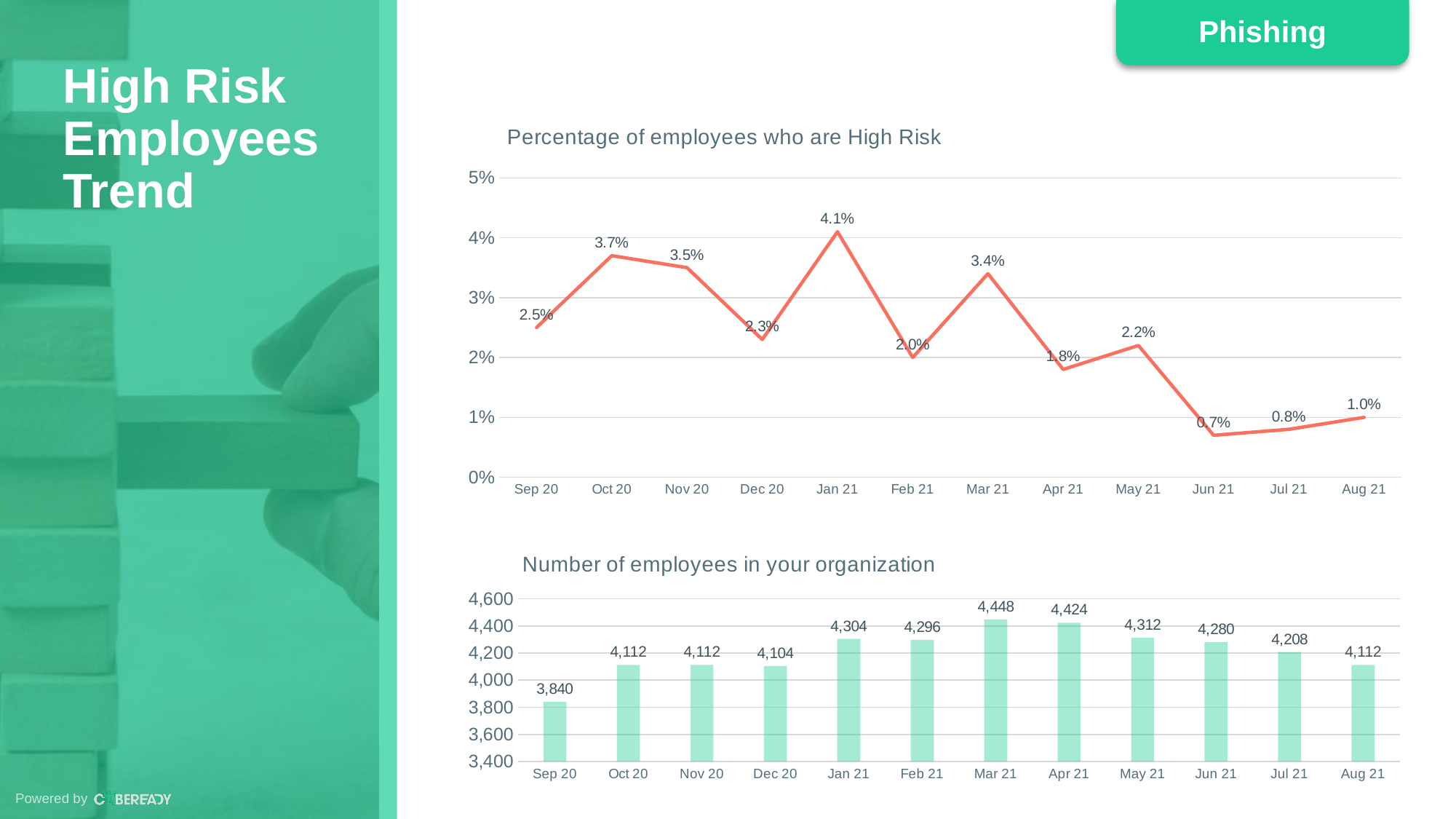
What type of chart is 'Percentage of employees who are High Risk'? Line chart What type of chart is 'Number of employees in your organization'? Bar chart In the 'Number of employees in your organization' chart, what is the value for Mar 21? 4,448 In the 'Number of employees in your organization' chart, is the value for Sep 20 greater or less than 4,000? less In the 'Percentage of employees who are High Risk' chart, which month has the highest value? Jan 21 How many months are plotted in the 'Percentage of employees who are High Risk' chart? 12 In the 'Number of employees in your organization' chart, which month has the lowest value? Sep 20 In the 'Number of employees in your organization' chart, what is the difference between the Mar 21 and Apr 21 values? 24 In the 'Percentage of employees who are High Risk' chart, what is the value for Jan 21? 4.1% In the 'Percentage of employees who are High Risk' chart, what is the difference between the Oct 20 and Sep 20 values? 1.2% In the 'Percentage of employees who are High Risk' chart, which month has the lowest value? Jun 21 In the 'Percentage of employees who are High Risk' chart, which is larger, the value for Mar 21 or the value for Nov 20? Nov 20